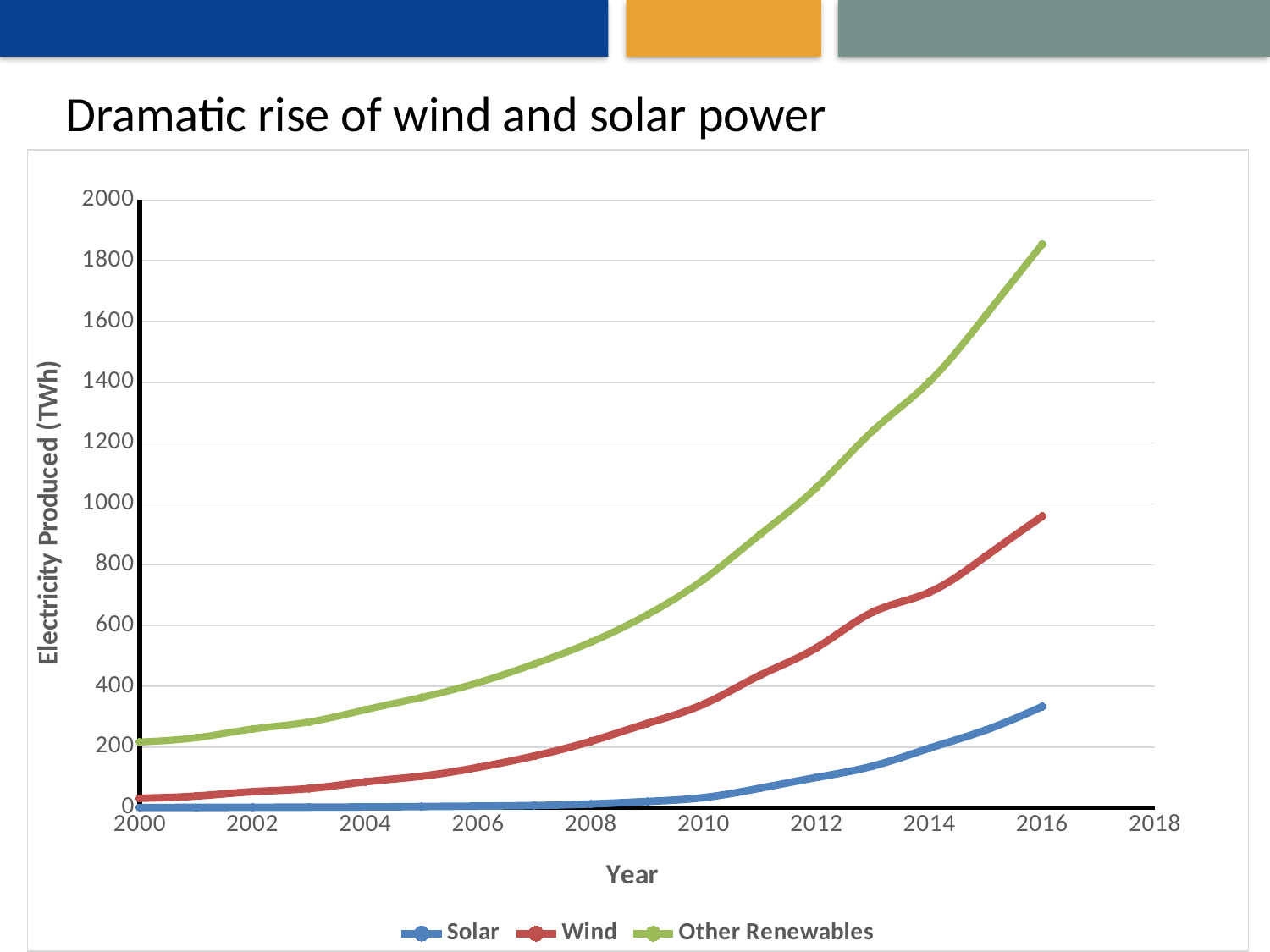
Is the value for Other Renewables in 2016 greater or less than 1600? greater Is the value for Wind in 2010 greater or less than 400? less What kind of chart is shown on the slide? line chart Do the values for Wind rise or fall from 2000 to 2016? rise What is the label of the vertical axis? Electricity Produced (TWh) Which is larger in 2014, the value for Wind or the value for Solar? Wind How many series does the legend list? 3 Is the value for Wind in 2016 greater or less than 800? greater Which series has the lowest value in 2016? Solar Which series has the highest value in 2016? Other Renewables